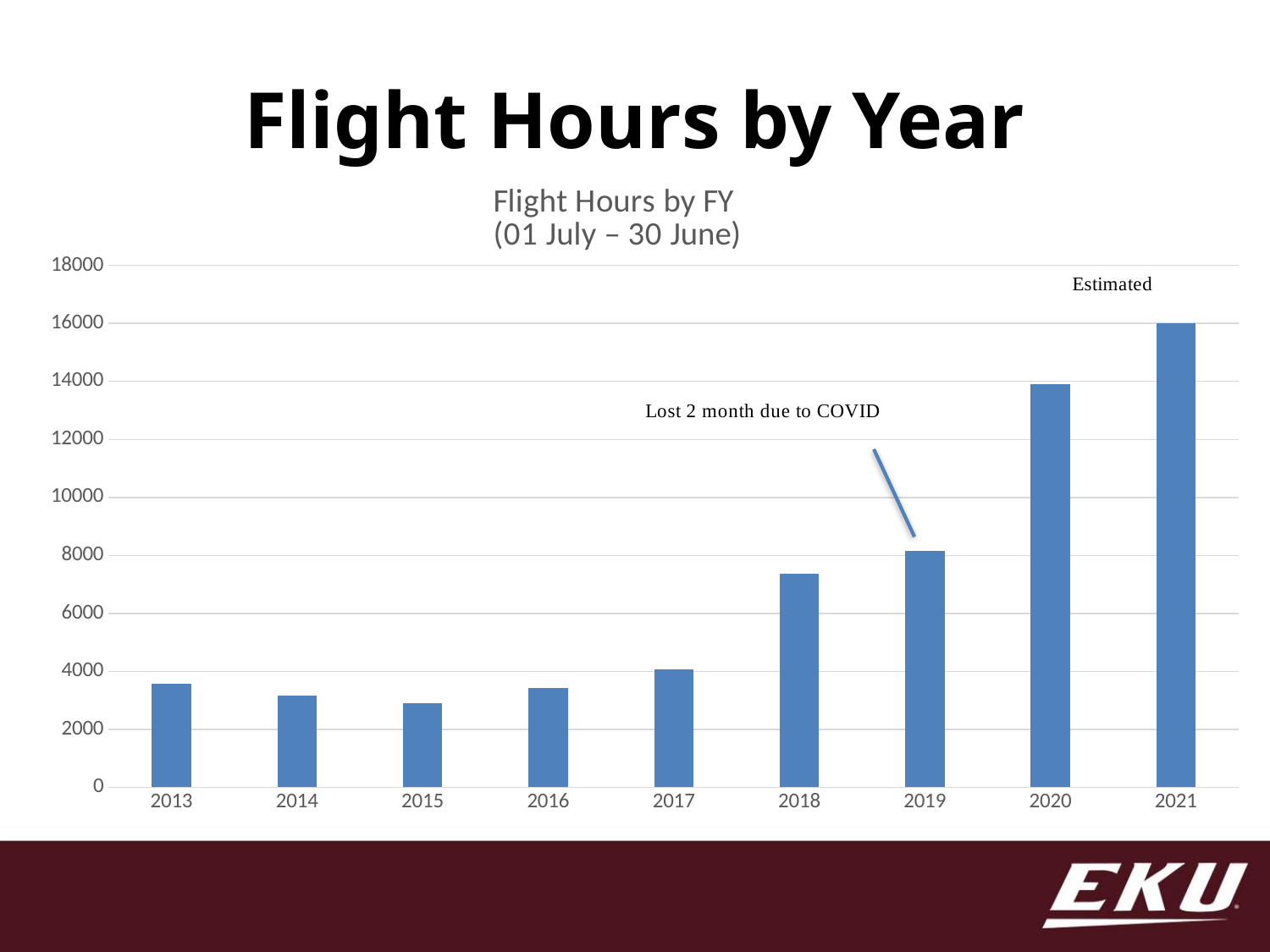
Which year has more flight hours, 2018 or 2019? 2019 Do the flight hours generally rise or fall from 2016 to 2021? rise What kind of chart is shown on the slide? bar chart Is the value for 2017 greater or less than 6000? less What is the title of the chart? Flight Hours by FY (01 July – 30 June) Which year has the lowest flight hours? 2015 How many years are plotted on the chart? 9 Is the value for 2020 greater or less than 12000? greater Is the value for 2018 greater or less than 6000? greater Which year's bar is labelled as estimated? 2021 Which year has more flight hours, 2013 or 2014? 2013 Which year has the highest flight hours? 2021